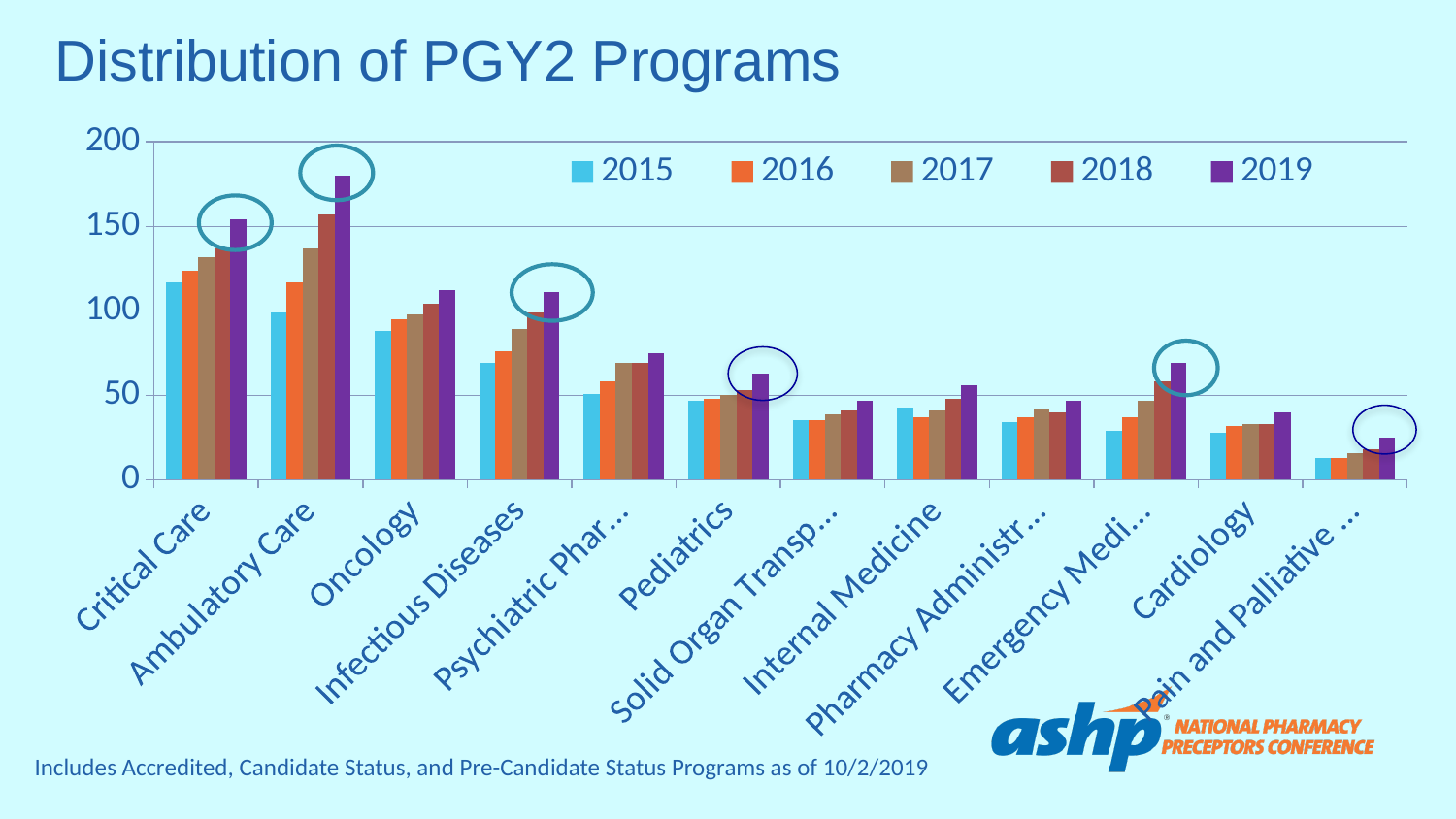
How many series does the legend list? 5 Is the value for Oncology in 2015 greater or less than 100? less Is the value for Critical Care in 2015 greater or less than 100? greater Do the values for Critical Care rise or fall from 2015 to 2019? rise Which category has the highest value for 2019? Ambulatory Care What kind of chart is shown on the slide? bar chart Which is larger, the 2019 value for Ambulatory Care or the 2019 value for Critical Care? Ambulatory Care Is the value for Pediatrics in 2019 greater or less than 50? greater How many categories are shown along the x axis? 12 What is the title of the chart? Distribution of PGY2 Programs